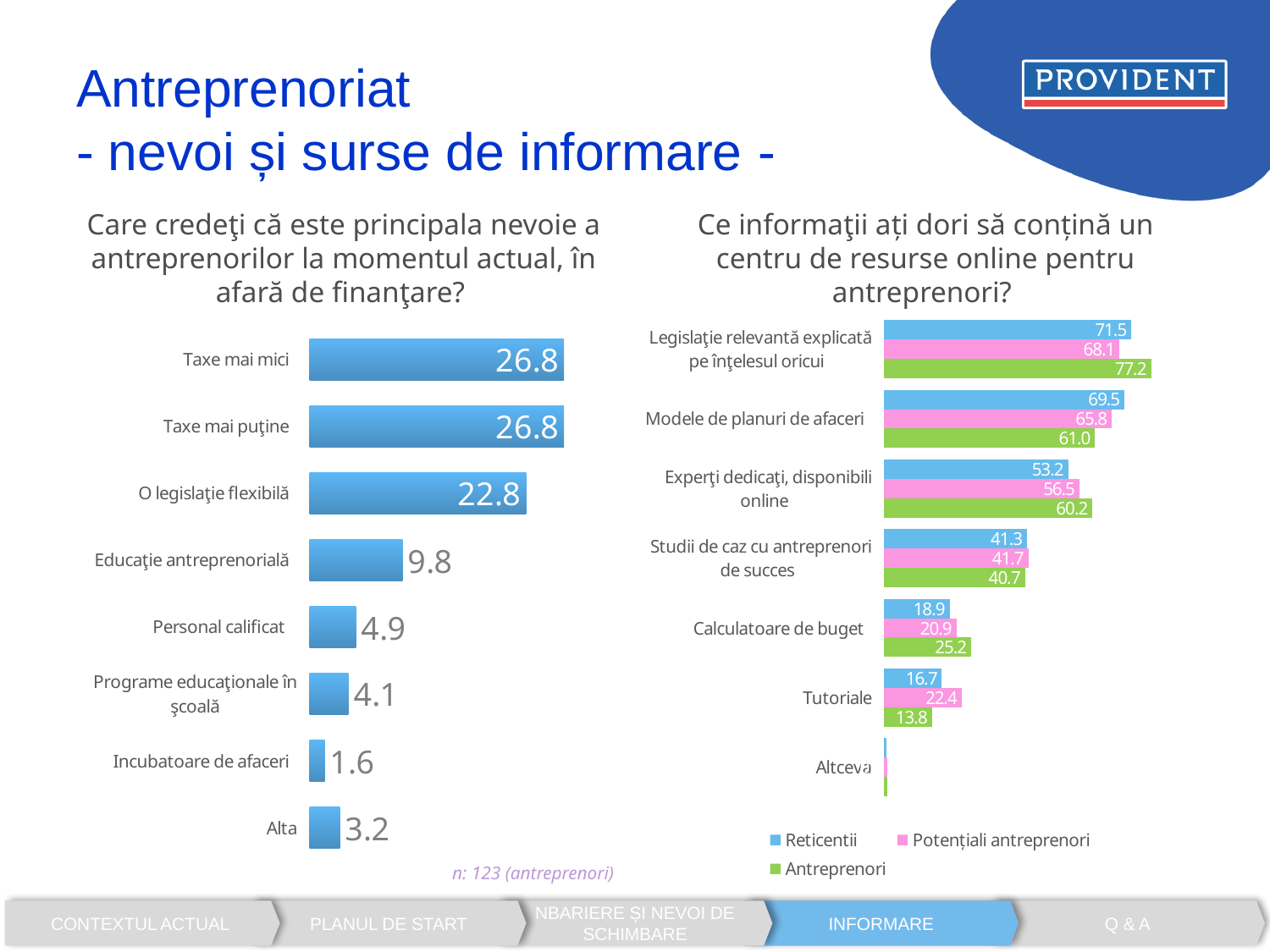
In the left chart, which category has the lowest value? Incubatoare de afaceri In the right chart, what is the difference between "Potențiali antreprenori" and "Antreprenori" on "Calculatoare de buget"? 4.3 How many series does the legend of the right chart list? 3 In the right chart, which colour represents "Potențiali antreprenori"? Pink In the left chart, which is larger: "Personal calificat" or "Alta"? Personal calificat In the right chart, which series has the highest value for "Experţi dedicaţi, disponibili online"? Antreprenori In the right chart, what is the value for "Reticentii" on "Tutoriale"? 16.7 In the right chart ("Ce informaţii ați dori să conțină un centru de resurse online..."), what is the value for "Antreprenori" on "Legislaţie relevantă explicată pe înţelesul oricui"? 77.2 What type of chart is the left chart? Bar chart In the left chart ("Care credeţi că este principala nevoie a antreprenorilor..."), what is the value for "O legislaţie flexibilă"? 22.8 In the left chart, what is the difference between "Taxe mai mici" and "Educaţie antreprenorială"? 17.0 How many categories does the left chart show? 8